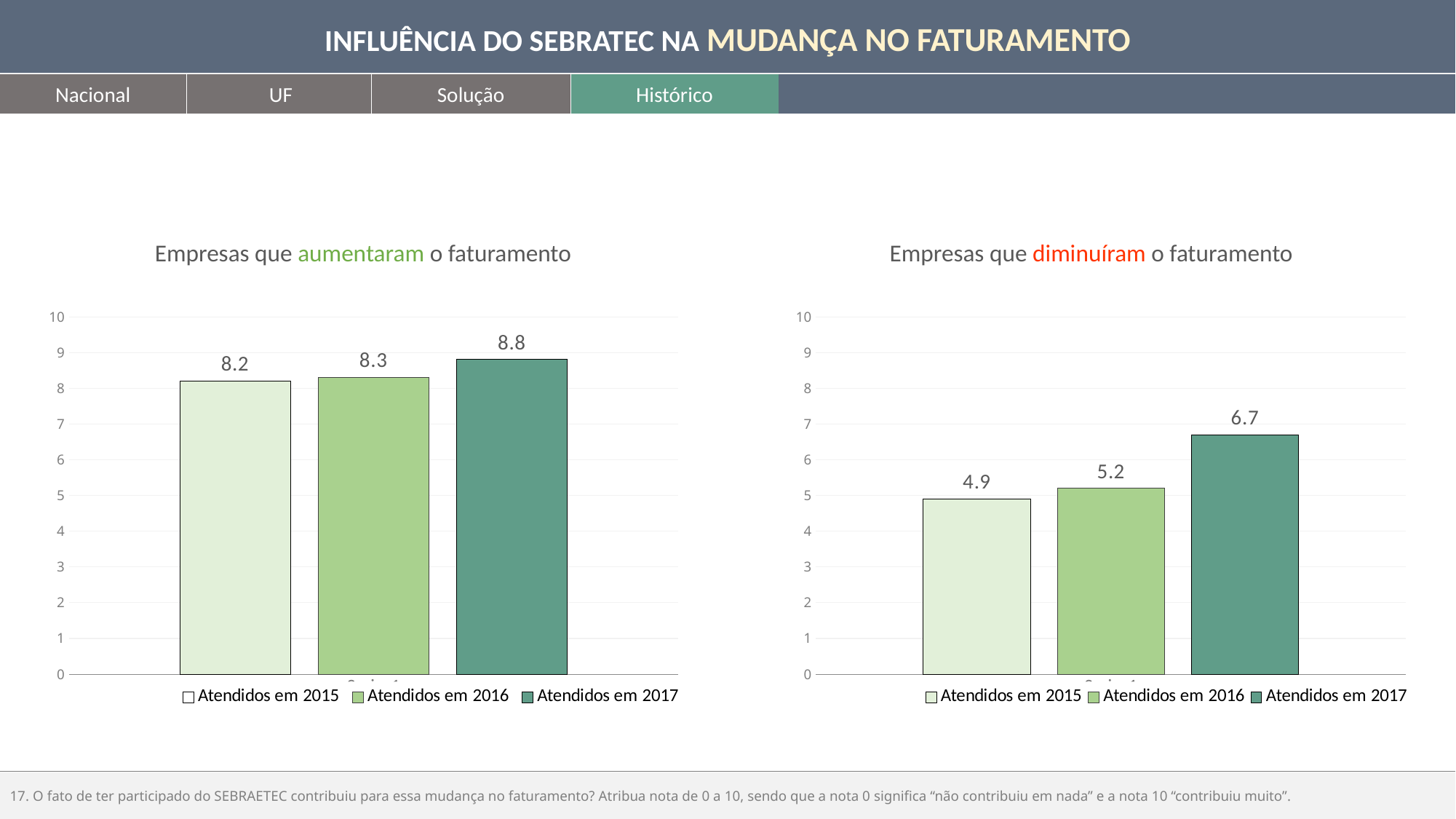
Which is larger: Atendidos em 2017 in the 'Empresas que aumentaram o faturamento' chart or Atendidos em 2017 in the 'Empresas que diminuíram o faturamento' chart? Atendidos em 2017 in 'Empresas que aumentaram o faturamento' What kind of chart is 'Empresas que diminuíram o faturamento'? bar chart In the chart 'Empresas que diminuíram o faturamento', what is the value for Atendidos em 2015? 4.9 In the chart 'Empresas que diminuíram o faturamento', what is the value for Atendidos em 2016? 5.2 In the chart 'Empresas que aumentaram o faturamento', which series has the highest value? Atendidos em 2017 How many series does the legend of the chart 'Empresas que aumentaram o faturamento' list? 3 In the chart 'Empresas que aumentaram o faturamento', what is the difference between Atendidos em 2017 and Atendidos em 2015? 0.6 In the chart 'Empresas que aumentaram o faturamento', do the values rise or fall from Atendidos em 2015 to Atendidos em 2017? rise In the chart 'Empresas que diminuíram o faturamento', what is the difference between Atendidos em 2017 and Atendidos em 2016? 1.5 In the chart 'Empresas que aumentaram o faturamento', what is the value for Atendidos em 2017? 8.8 In the chart 'Empresas que diminuíram o faturamento', which series has the lowest value? Atendidos em 2015 In the chart 'Empresas que diminuíram o faturamento', is the value for Atendidos em 2017 greater or less than 6? greater